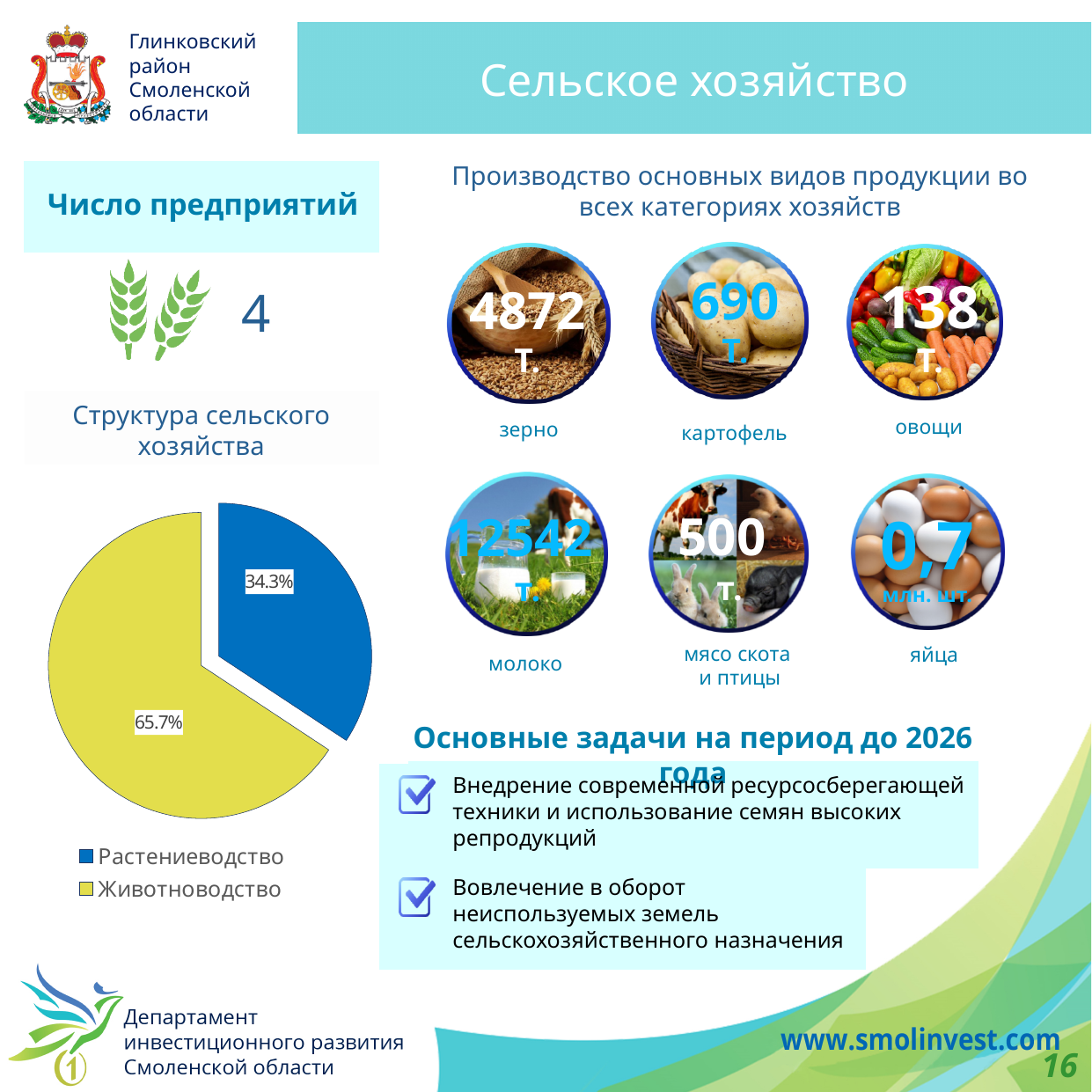
What colour is the Животноводство slice in the pie chart? yellow What colour is the Растениеводство slice in the pie chart? blue In the pie chart, what share is shown for Животноводство? 65.7% In the pie chart, which is larger: Растениеводство or Животноводство? Животноводство How many slices does the pie chart have? 2 In the pie chart, what share is shown for Растениеводство? 34.3% What is the total of the two shares shown in the pie chart? 100% Which slice of the pie chart is the largest? Животноводство Which slice of the pie chart is the smallest? Растениеводство How many entries does the pie chart legend list? 2 What kind of chart is shown under the heading "Структура сельского хозяйства"? pie chart By how many percentage points does the Животноводство share exceed the Растениеводство share in the pie chart? 31.4